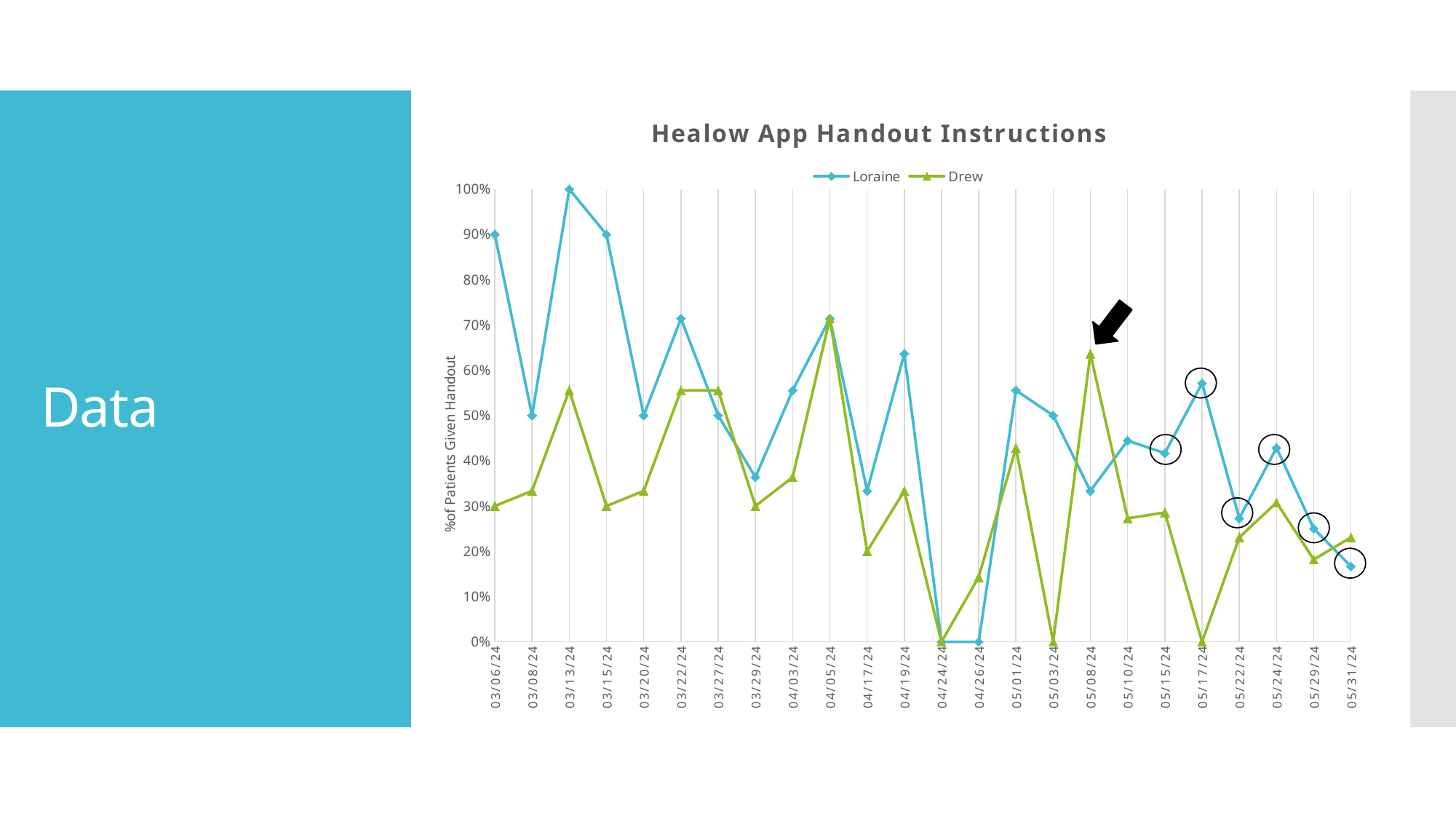
Is Drew's value on 05/08/24 greater or less than 50%? greater How many dates are plotted along the x axis? 24 What is the title of the chart? Healow App Handout Instructions On which date does Loraine reach her highest value? 03/13/24 On 05/08/24, who has the higher value, Loraine or Drew? Drew What is Drew's value on 03/06/24? 30% What is Loraine's value on 03/13/24? 100% What type of chart is shown on the slide? Line chart How many series does the legend list? 2 Is Loraine's value on 05/31/24 greater or less than 20%? less What is the difference between Loraine's value on 03/06/24 and Drew's value on 03/06/24? 60% On which date does Drew reach his highest value? 04/05/24